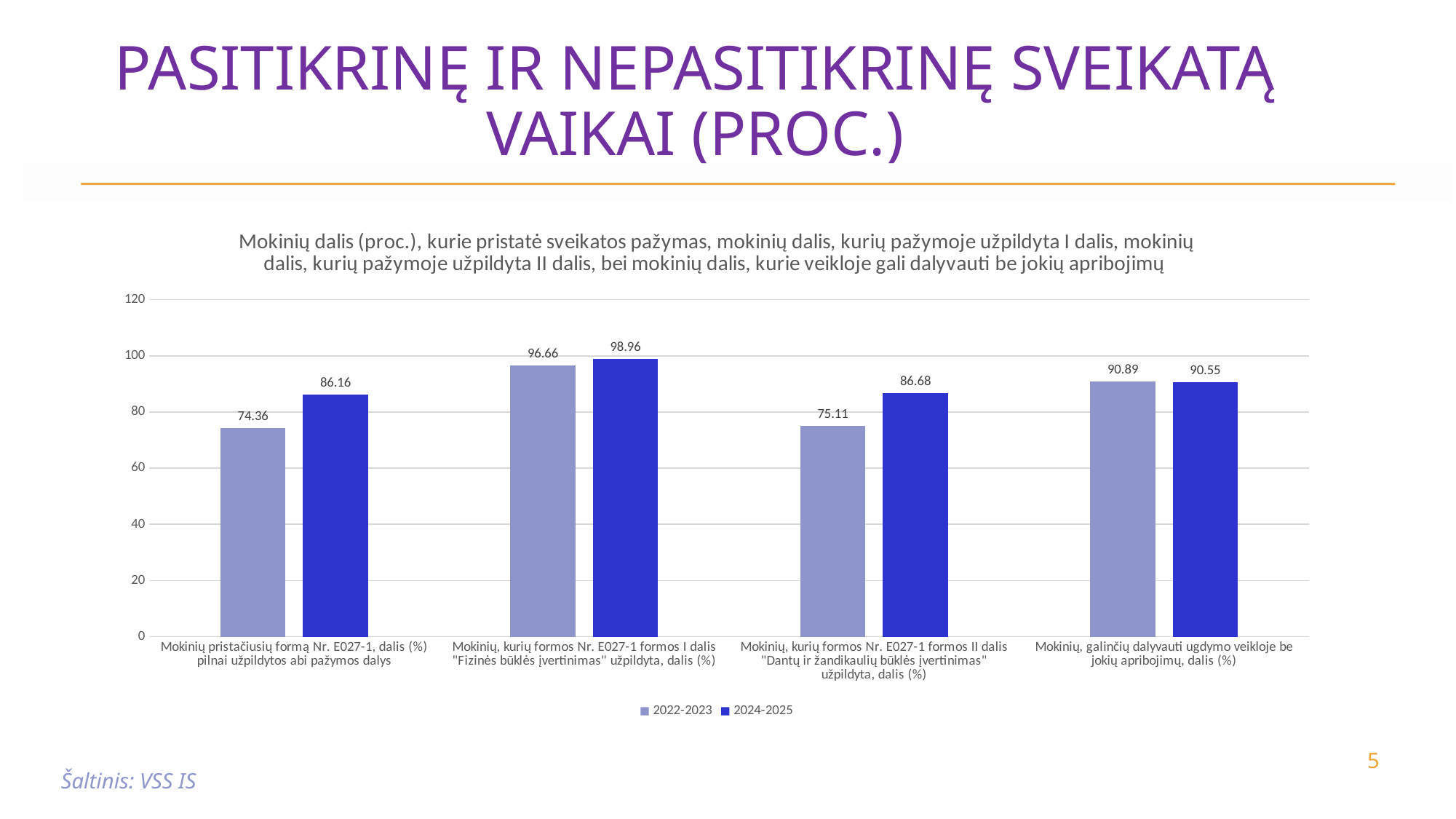
What type of chart is shown on the slide? Bar chart For 'Mokinių, kurių formos Nr. E027-1 formos II dalis "Dantų ir žandikaulių būklės įvertinimas" užpildyta, dalis (%)', which is larger: the 2022-2023 value or the 2024-2025 value? 2024-2025 What is the 2024-2025 value for 'Mokinių, kurių formos Nr. E027-1 formos I dalis "Fizinės būklės įvertinimas" užpildyta, dalis (%)'? 98.96 What is the 2022-2023 value for 'Mokinių, galinčių dalyvauti ugdymo veikloje be jokių apribojimų, dalis (%)'? 90.89 What is the 2024-2025 value for 'Mokinių, kurių formos Nr. E027-1 formos II dalis "Dantų ir žandikaulių būklės įvertinimas" užpildyta, dalis (%)'? 86.68 How many series does the chart legend list? 2 Which category has the highest 2024-2025 value? Mokinių, kurių formos Nr. E027-1 formos I dalis "Fizinės būklės įvertinimas" užpildyta, dalis (%) What is the 2022-2023 value for 'Mokinių pristačiusių formą Nr. E027-1, dalis (%) pilnai užpildytos abi pažymos dalys'? 74.36 How many categories are shown on the x axis of the chart? 4 What is the difference between the 2024-2025 and 2022-2023 values for 'Mokinių, kurių formos Nr. E027-1 formos I dalis "Fizinės būklės įvertinimas" užpildyta, dalis (%)'? 2.30 What is the difference between the 2024-2025 and 2022-2023 values for 'Mokinių pristačiusių formą Nr. E027-1, dalis (%) pilnai užpildytos abi pažymos dalys'? 11.80 Which category has the lowest 2022-2023 value? Mokinių pristačiusių formą Nr. E027-1, dalis (%) pilnai užpildytos abi pažymos dalys